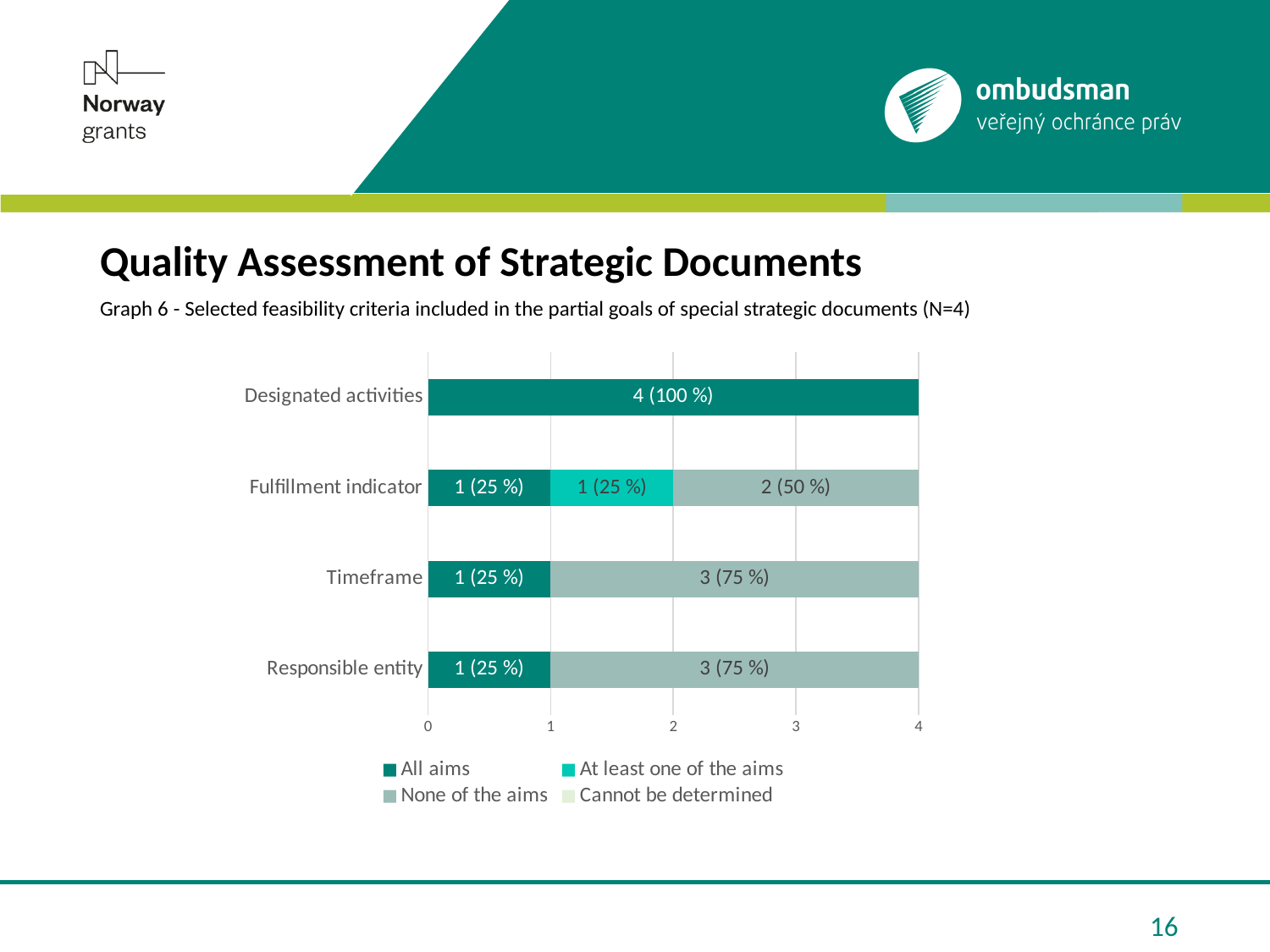
What is the title of the graph shown on the slide? Graph 6 - Selected feasibility criteria included in the partial goals of special strategic documents (N=4) Which category has the highest value for 'All aims'? Designated activities What is the value for 'All aims' in the Designated activities bar? 4 (100 %) What is the value for 'All aims' in the Responsible entity bar? 1 (25 %) What is the value for 'None of the aims' in the Timeframe bar? 3 (75 %) How many series does the legend list? 4 What is the difference between the 'None of the aims' value for Timeframe and the 'None of the aims' value for Fulfillment indicator? 1 Which is larger in the Fulfillment indicator bar: the 'All aims' value or the 'None of the aims' value? None of the aims What is the value for 'None of the aims' in the Fulfillment indicator bar? 2 (50 %) How many categories are shown on the chart? 4 What is the value for 'At least one of the aims' in the Fulfillment indicator bar? 1 (25 %) What kind of chart is shown on the slide? Stacked bar chart